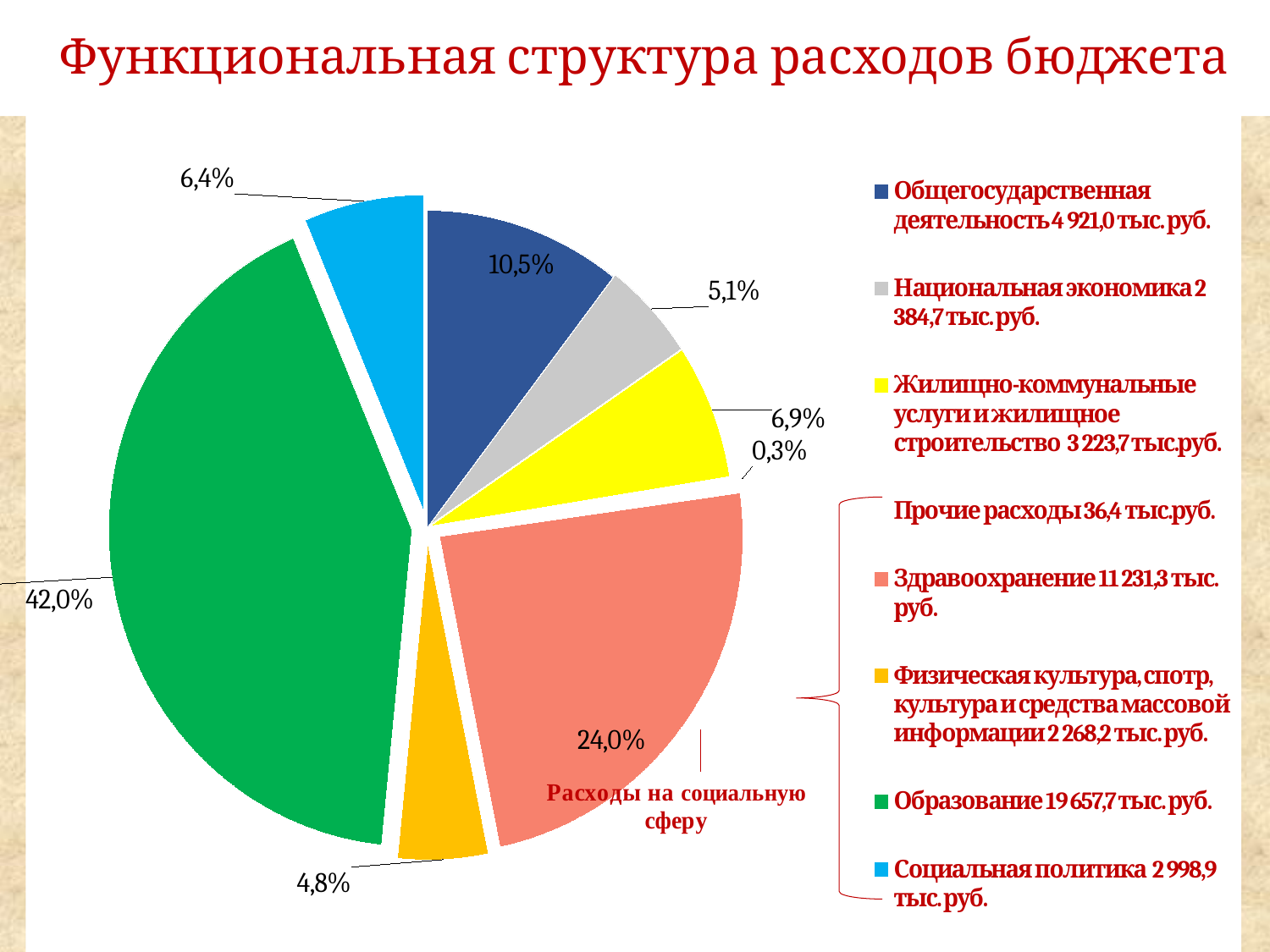
Which category has the smallest share of the pie? Прочие расходы What kind of chart is shown on the slide? pie chart Which category has the largest share of the pie? Образование What is the title of the chart? Функциональная структура расходов бюджета What share of the pie does Общегосударственная деятельность take? 10,5% What share of the pie does Здравоохранение take? 24,0% According to the legend, what is the amount for Образование in тыс. руб.? 19 657,7 тыс. руб. How many slices does the pie chart have? 8 Which slice is larger: Социальная политика or Национальная экономика? Социальная политика How many entries does the legend list? 8 What is the difference in percentage points between the Образование and Здравоохранение slices? 18,0% What share of the pie does Образование take? 42,0%